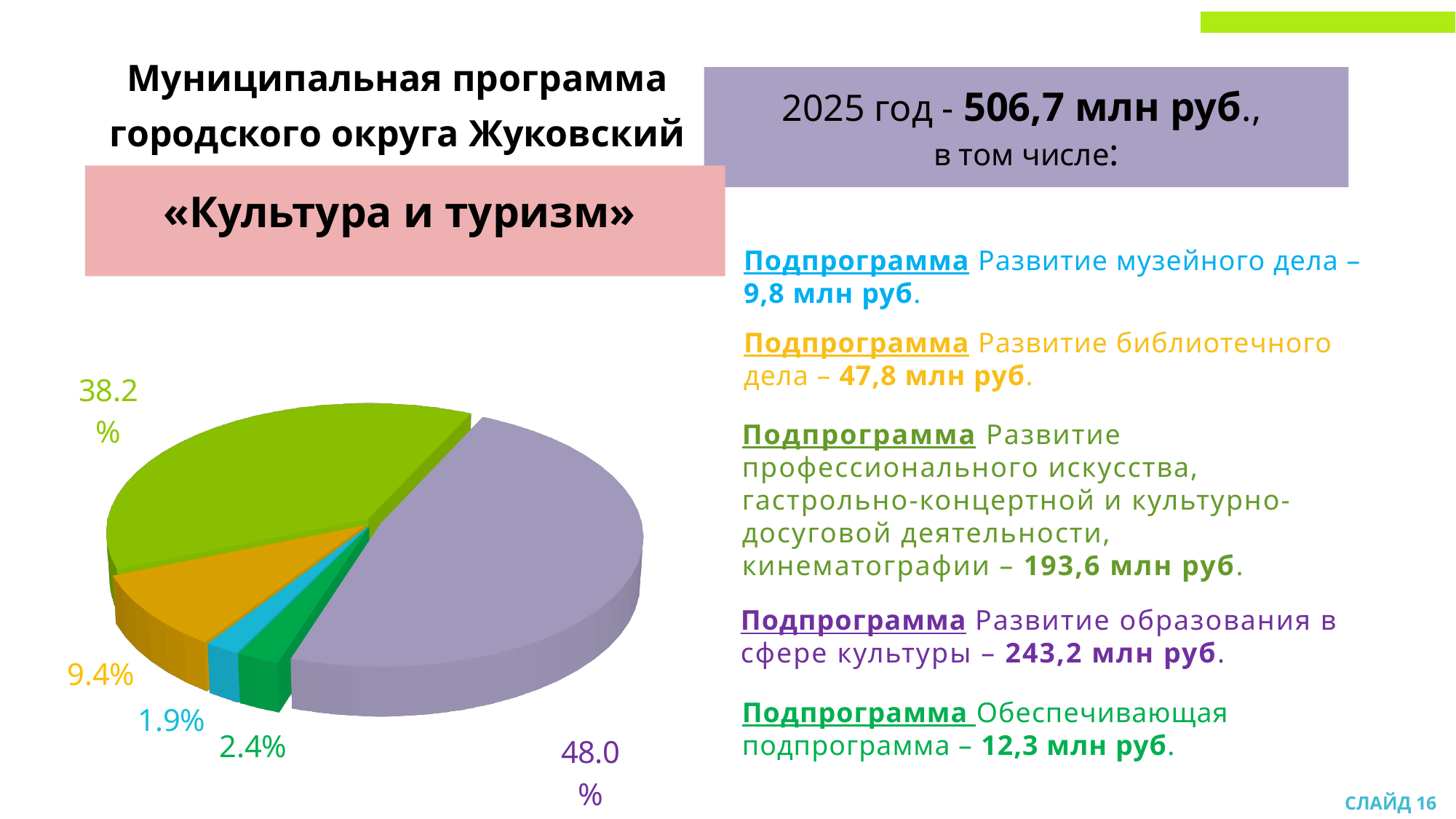
Which slice is larger: the orange slice at 9.4% or the dark green slice at 2.4%? the orange slice (9.4%) What percentage is shown for the blue slice of the pie chart? 1.9% What percentage is shown for the orange slice of the pie chart? 9.4% What is the smallest percentage shown on the pie chart? 1.9% How many slices does the pie chart have? 5 What kind of chart is shown on the slide? pie chart What is the largest percentage shown on the pie chart? 48.0% What percentage is shown for the dark green slice of the pie chart? 2.4% What is the difference in percentage points between the largest slice (48.0%) and the second largest slice (38.2%)? 9.8 Is the share of the purple slice greater or less than 50%? less What percentage is shown for the light green slice of the pie chart? 38.2% What percentage is shown for the purple slice of the pie chart? 48.0%